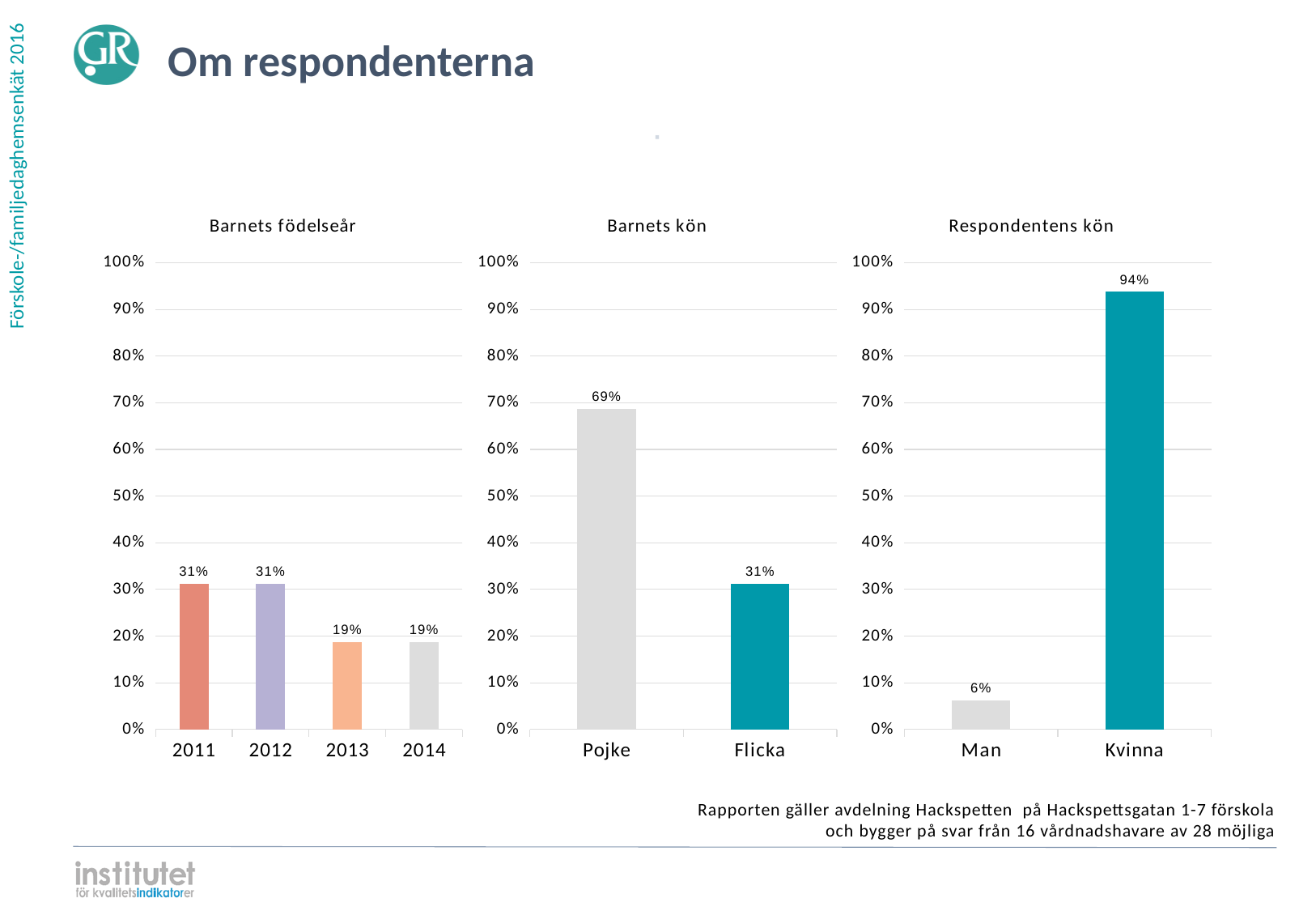
In the 'Respondentens kön' chart, what is the value for Kvinna? 94% In the 'Barnets födelseår' chart, what is the difference between the values for 2012 and 2014? 12% In the 'Barnets födelseår' chart, what is the value for 2013? 19% How many charts are shown on the slide? 3 In the 'Barnets kön' chart, which category has the lowest value? Flicka In the 'Barnets födelseår' chart, what is the value for 2011? 31% In the 'Respondentens kön' chart, which category has the highest value? Kvinna In the 'Barnets kön' chart, what is the value for Pojke? 69% What kind of chart is the 'Barnets kön' chart? Bar chart In the 'Respondentens kön' chart, is the value for Man greater or less than 10%? less In the 'Barnets kön' chart, what is the difference between Pojke and Flicka? 38% In the 'Barnets födelseår' chart, how many categories are shown on the x axis? 4